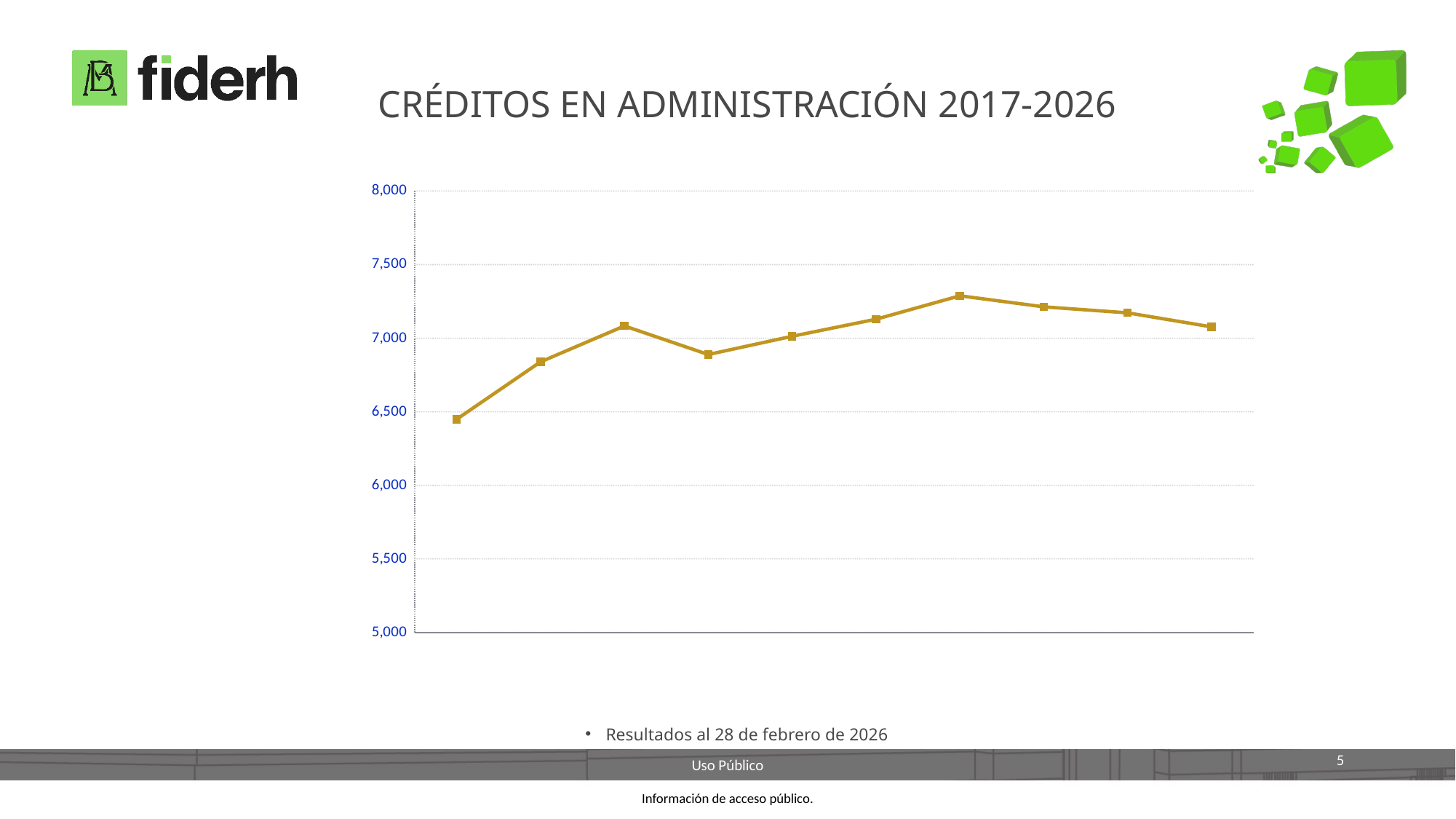
Is the value of the fourth point from the left greater or less than 7,000? less What kind of chart is shown on the slide? line chart Which point on the line has the lowest value? the first (leftmost) point How many data points are plotted on the line? 10 Is the first point or the last point of the line higher? the last point Is the value of the second point from the left greater or less than 6,500? greater Is the value of the first (leftmost) point greater or less than 6,500? less Which point on the line has the highest value? the seventh point from the left What is the title of the chart? CRÉDITOS EN ADMINISTRACIÓN 2017-2026 What is the highest value shown on the vertical axis? 8,000